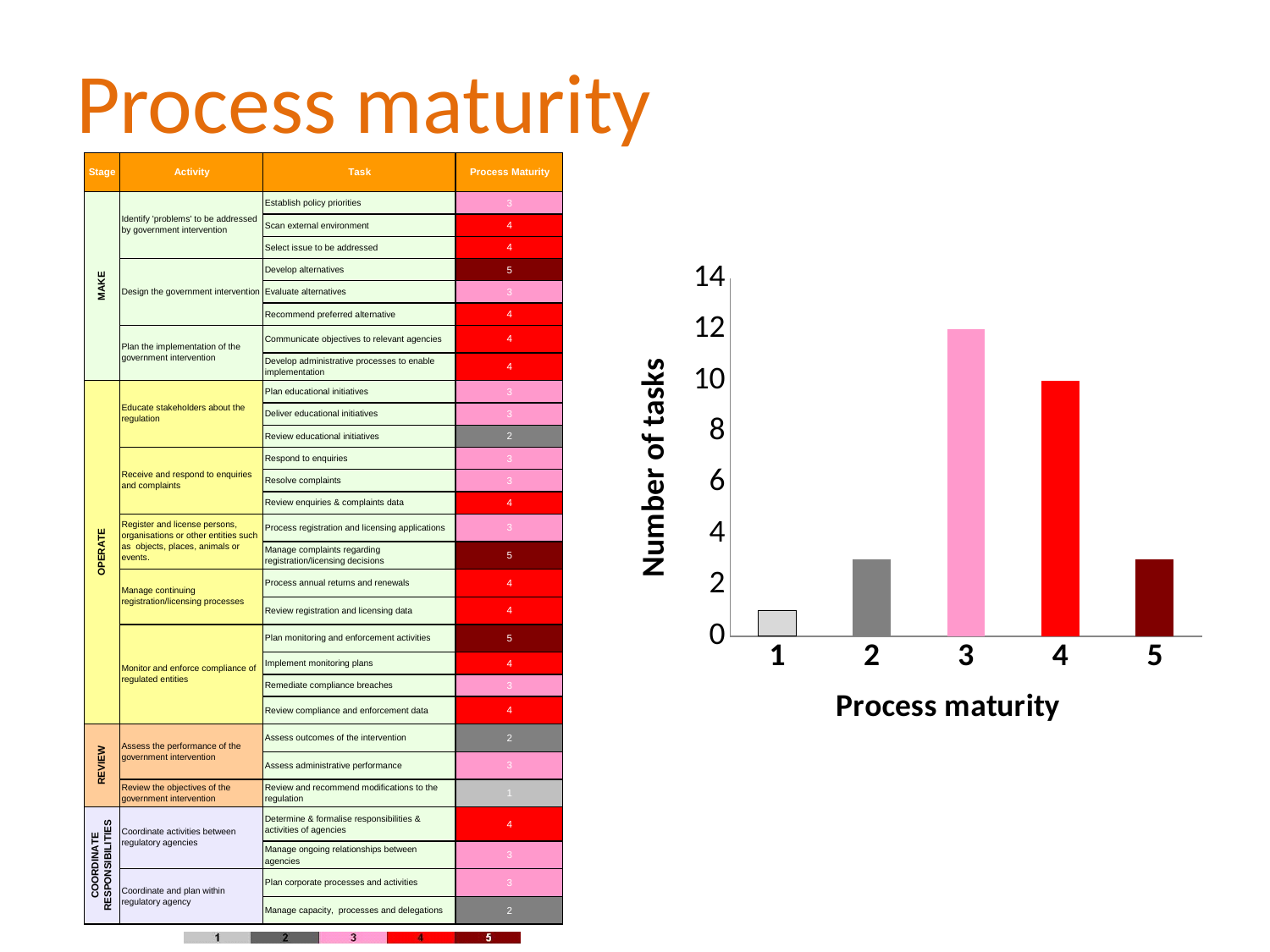
Which has more tasks: process maturity level 2 or level 4? 4 Which process maturity level has the highest number of tasks? 3 What is the difference in number of tasks between process maturity level 3 and level 4? 2 What is the number of tasks for process maturity level 3? 12 What is the label of the x axis of the chart? Process maturity Which process maturity level has the lowest number of tasks? 1 Is the number of tasks for process maturity level 1 greater or less than 2? less What is the label of the y axis of the chart? Number of tasks Is the number of tasks for process maturity level 5 greater or less than 4? less What is the number of tasks for process maturity level 4? 10 How many process maturity categories are plotted on the x axis of the chart? 5 What type of chart is shown on the slide? bar chart